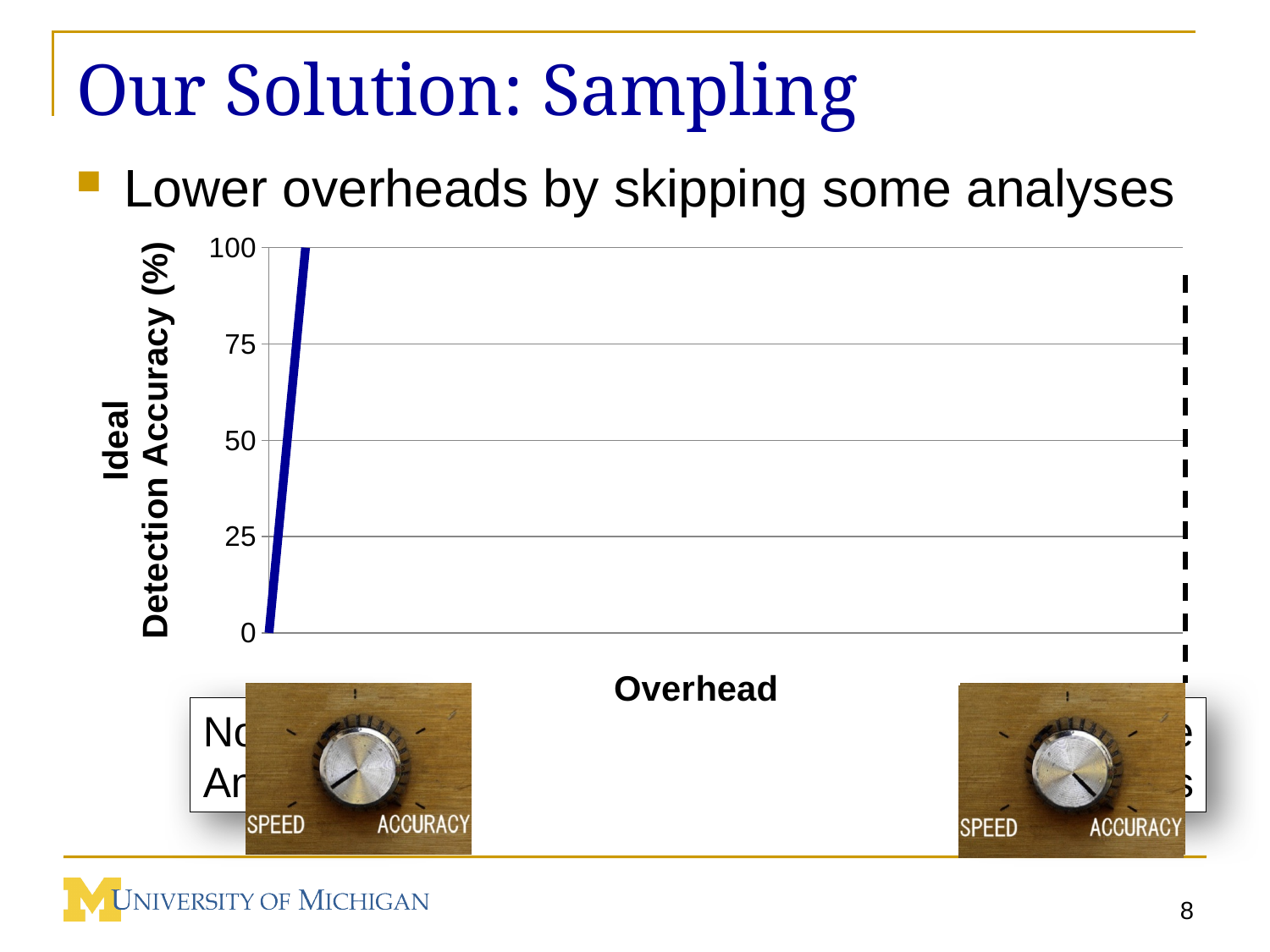
What is the lowest value shown on the y axis of the chart? 0 Does the blue line rise or fall as overhead increases along the x axis? rises What is the label of the y axis of the chart? Detection Accuracy (%) How many tick labels are shown on the y axis of the chart? 5 What kind of chart is shown on the slide? line chart What is the label of the x axis of the chart? Overhead What is the highest value shown on the y axis of the chart? 100